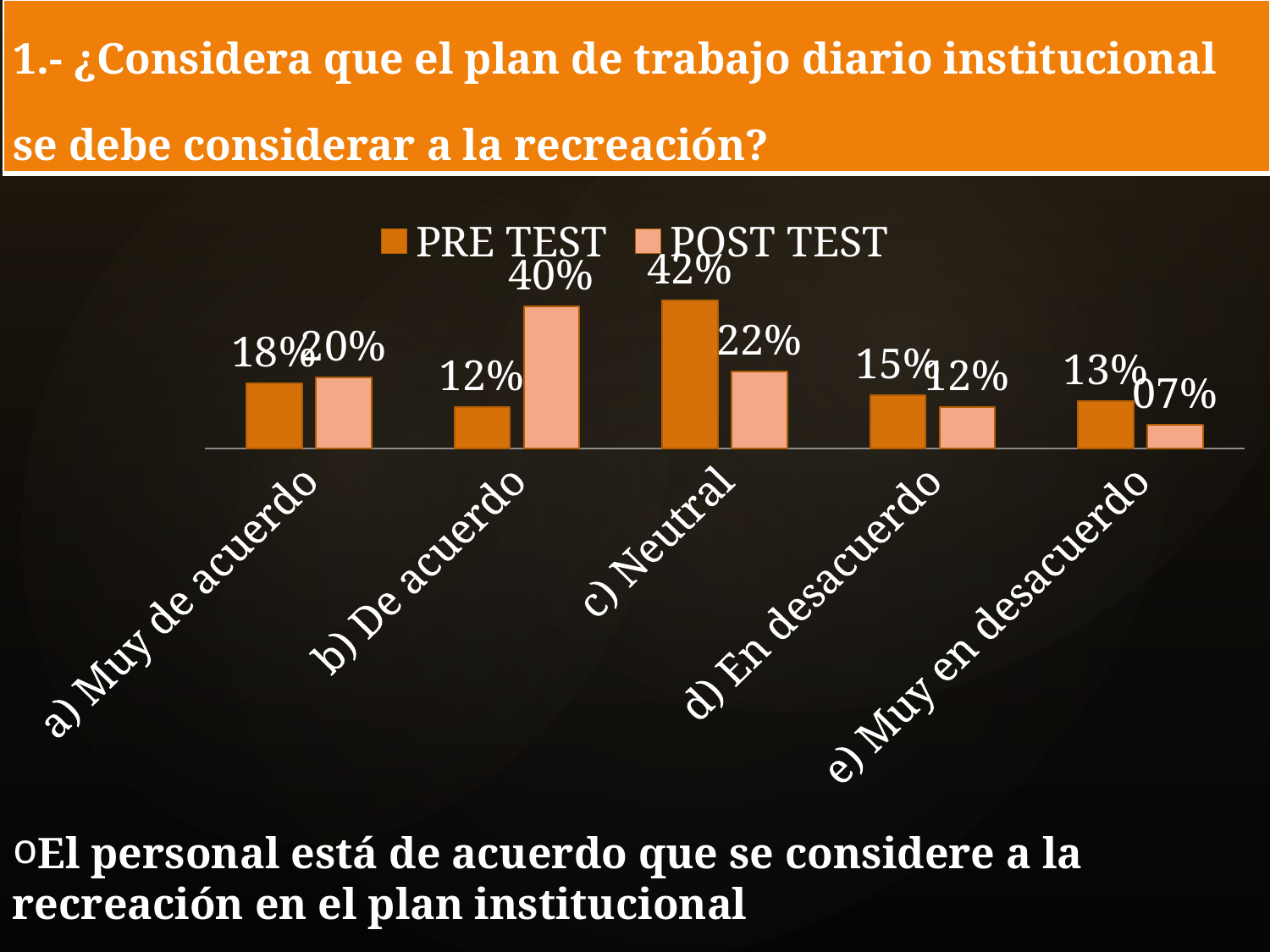
What kind of chart is shown on the slide? bar chart How many series does the legend list? 2 Which category has the highest PRE TEST value? c) Neutral Which category has the lowest POST TEST value? e) Muy en desacuerdo What is the POST TEST value for e) Muy en desacuerdo? 07% How many categories are shown on the x axis? 5 What is the PRE TEST value for b) De acuerdo? 12% What is the PRE TEST value for c) Neutral? 42% What is the POST TEST value for b) De acuerdo? 40% What are the two series named in the legend? PRE TEST and POST TEST What is the difference between the POST TEST and PRE TEST values for b) De acuerdo? 28% For c) Neutral, which is larger, the PRE TEST or the POST TEST value? PRE TEST